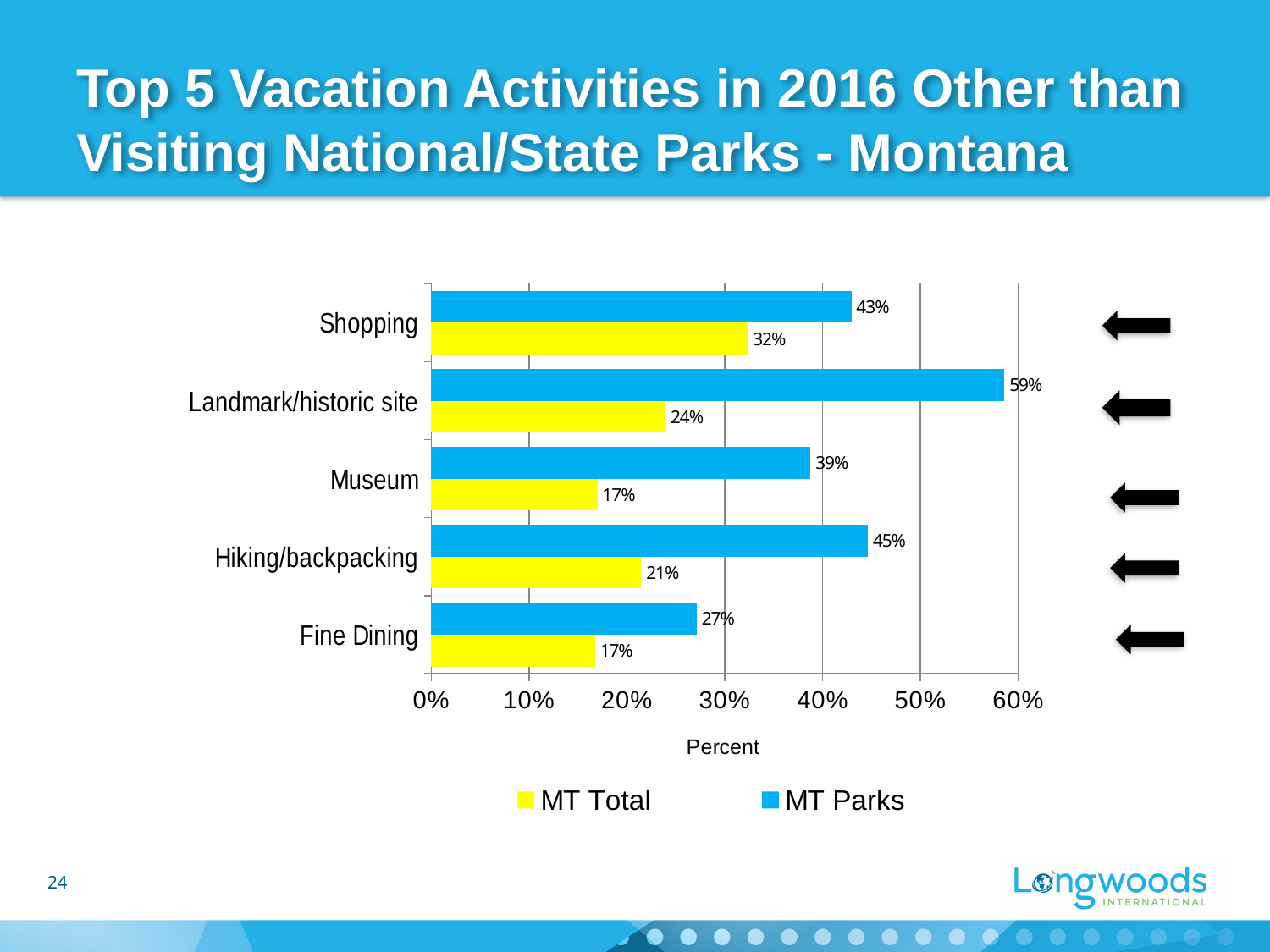
What kind of chart is shown on the slide? Bar chart Which activity has the lowest MT Parks value? Fine Dining What is the MT Parks value for Landmark/historic site? 59% What is the MT Total value for Shopping? 32% Which is larger, the MT Parks value for Shopping or the MT Parks value for Hiking/backpacking? Hiking/backpacking How many series does the legend list? 2 How many activities are shown on the chart? 5 Which activity has the highest MT Parks value? Landmark/historic site What is the difference between the MT Parks and MT Total values for Museum? 22% Which colour represents the MT Total series? Yellow Is the MT Parks value for Landmark/historic site greater or less than 50%? greater What is the MT Total value for Hiking/backpacking? 21%